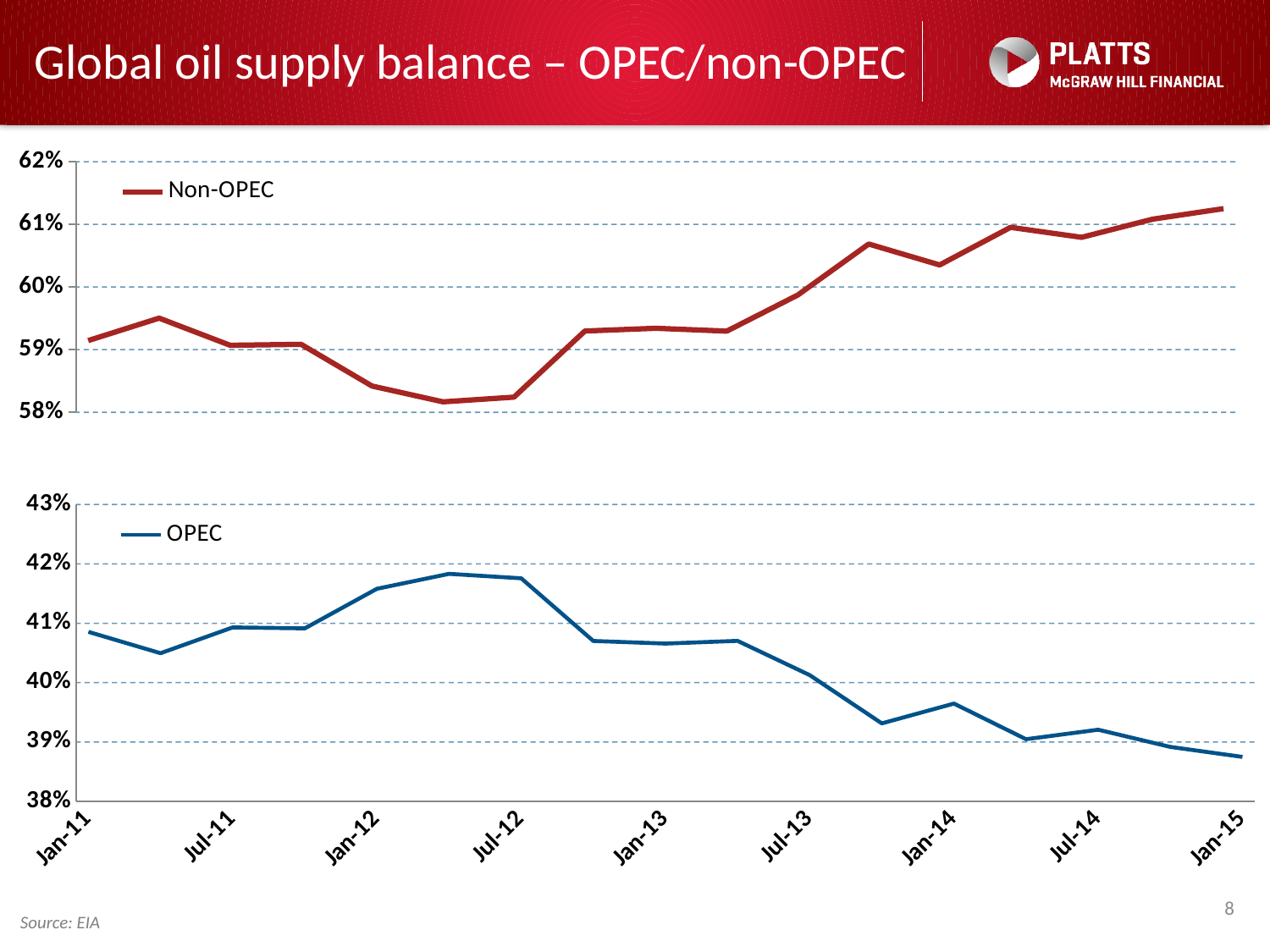
In the top chart, at which labelled date is the Non-OPEC share highest? Jan-15 In the bottom chart, is the OPEC value at Jan-15 greater or less than 39%? less In the top chart, is the Non-OPEC value at Jan-14 greater or less than 60%? greater In the bottom chart, is the OPEC value at Jul-12 greater or less than 42%? less In the top chart, does the Non-OPEC share generally rise or fall from Jan-11 to Jan-15? Rise What kind of chart is the top chart showing Non-OPEC? Line chart What colour is the OPEC line in the bottom chart? Blue In the bottom chart, at which labelled date is the OPEC share lowest? Jan-15 In the bottom chart, does the OPEC share generally rise or fall from Jan-11 to Jan-15? Fall